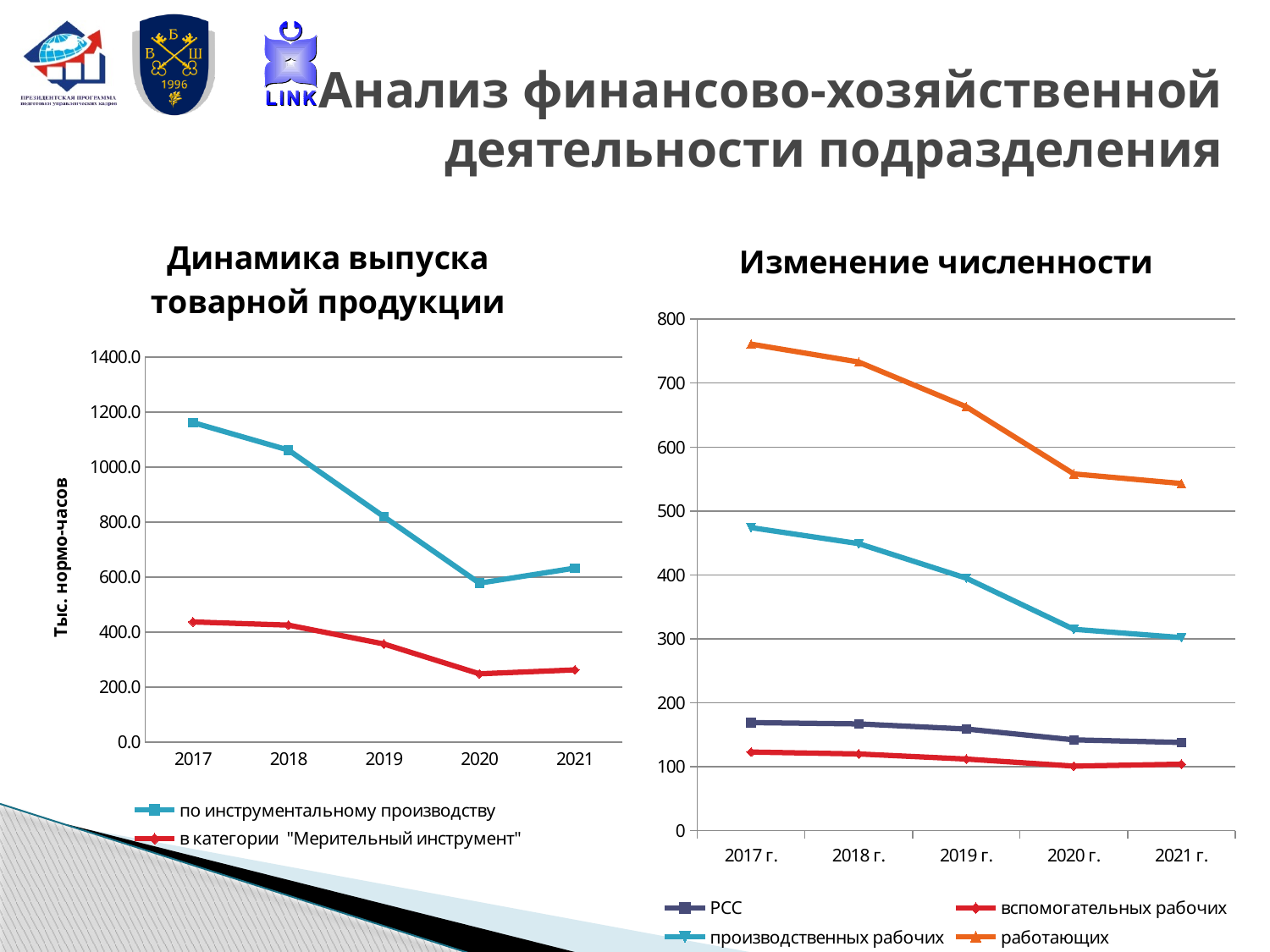
In the 'Изменение численности' chart, which is larger in 2017 г.: 'производственных рабочих' or 'РСС'? производственных рабочих In the 'Динамика выпуска товарной продукции' chart, is the 2017 value for 'по инструментальному производству' greater or less than 1000.0? greater In the 'Изменение численности' chart, is the 2017 г. value for 'производственных рабочих' greater or less than 400? greater In the 'Динамика выпуска товарной продукции' chart, in which year is the value for 'по инструментальному производству' highest? 2017 What kind of chart is the 'Динамика выпуска товарной продукции' chart? line chart How many years are shown on the x axis of the 'Динамика выпуска товарной продукции' chart? 5 In the 'Динамика выпуска товарной продукции' chart, in which year is the value for 'по инструментальному производству' lowest? 2020 What is the y-axis label of the 'Динамика выпуска товарной продукции' chart? Тыс. нормо-часов In the 'Изменение численности' chart, is the 2019 г. value for 'работающих' greater or less than 700? less In the 'Изменение численности' chart, do the values for 'работающих' rise or fall from 2017 г. to 2021 г.? fall How many series does the legend of the 'Изменение численности' chart list? 4